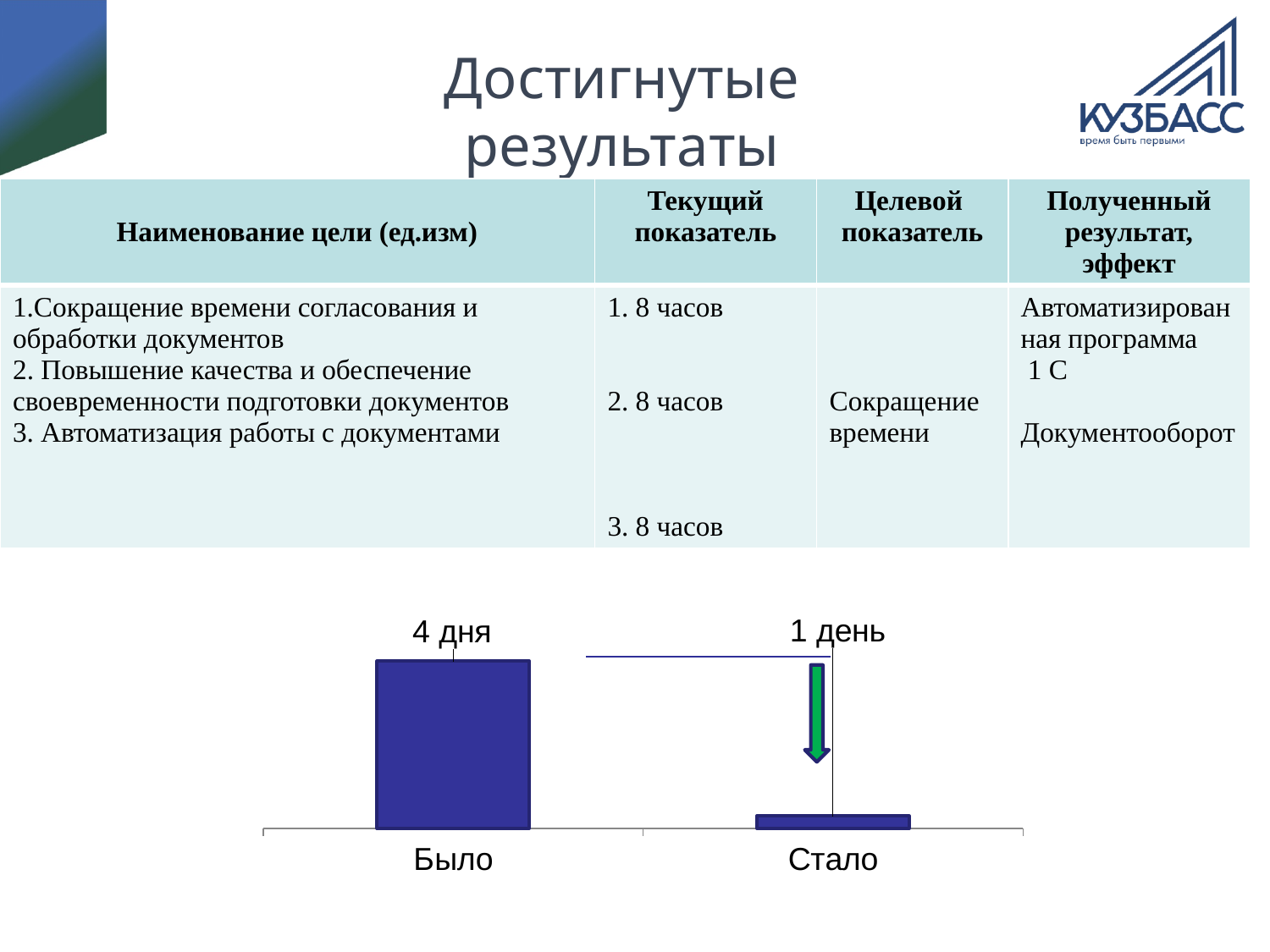
How many categories are shown in the bar chart? 2 What is the value for "Было" in the bar chart? 4 дня What kind of chart is shown at the bottom of the slide? Bar chart What is the value for "Стало" in the bar chart? 1 день By how many days does the value for "Было" exceed the value for "Стало"? 3 дня What are the category labels on the x axis of the bar chart? Было, Стало Which is larger in the bar chart: the value for "Было" or the value for "Стало"? Было Which category has the highest value in the bar chart? Было Do the values rise or fall from "Было" to "Стало" in the bar chart? Fall Which category has the lowest value in the bar chart? Стало What colour are the bars in the chart? Dark blue